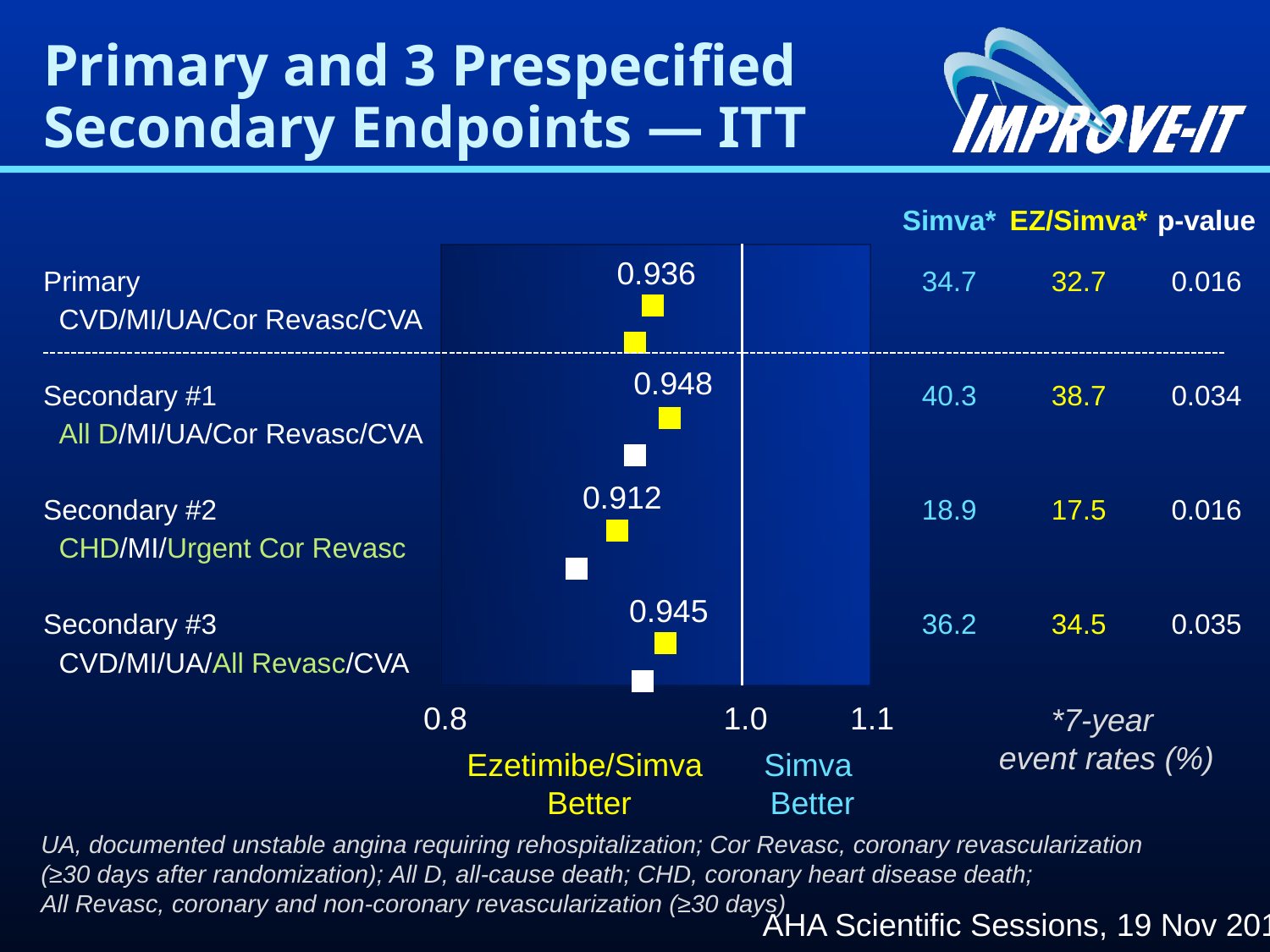
Which side of the chart is labelled 'Ezetimibe/Simva Better'? The left side (below 1.0) What is the hazard ratio shown for Secondary #3 (CVD/MI/UA/All Revasc/CVA)? 0.945 What is the p-value listed for Secondary #1 (All D/MI/UA/Cor Revasc/CVA)? 0.034 Is the hazard ratio for Secondary #3 greater or less than 1.0? less What is the hazard ratio shown for Secondary #2 (CHD/MI/Urgent Cor Revasc)? 0.912 What is the 7-year event rate for EZ/Simva on the Primary endpoint? 32.7 How many endpoints are plotted on the chart? 4 What is the hazard ratio shown for the Primary endpoint (CVD/MI/UA/Cor Revasc/CVA)? 0.936 What is the difference between the hazard ratios for Secondary #1 and Secondary #2? 0.036 Which endpoint has the lowest hazard ratio on the chart? Secondary #2 Which has the larger hazard ratio, the Primary endpoint or Secondary #2? Primary What is the difference between the Simva and EZ/Simva 7-year event rates for the Primary endpoint? 2.0